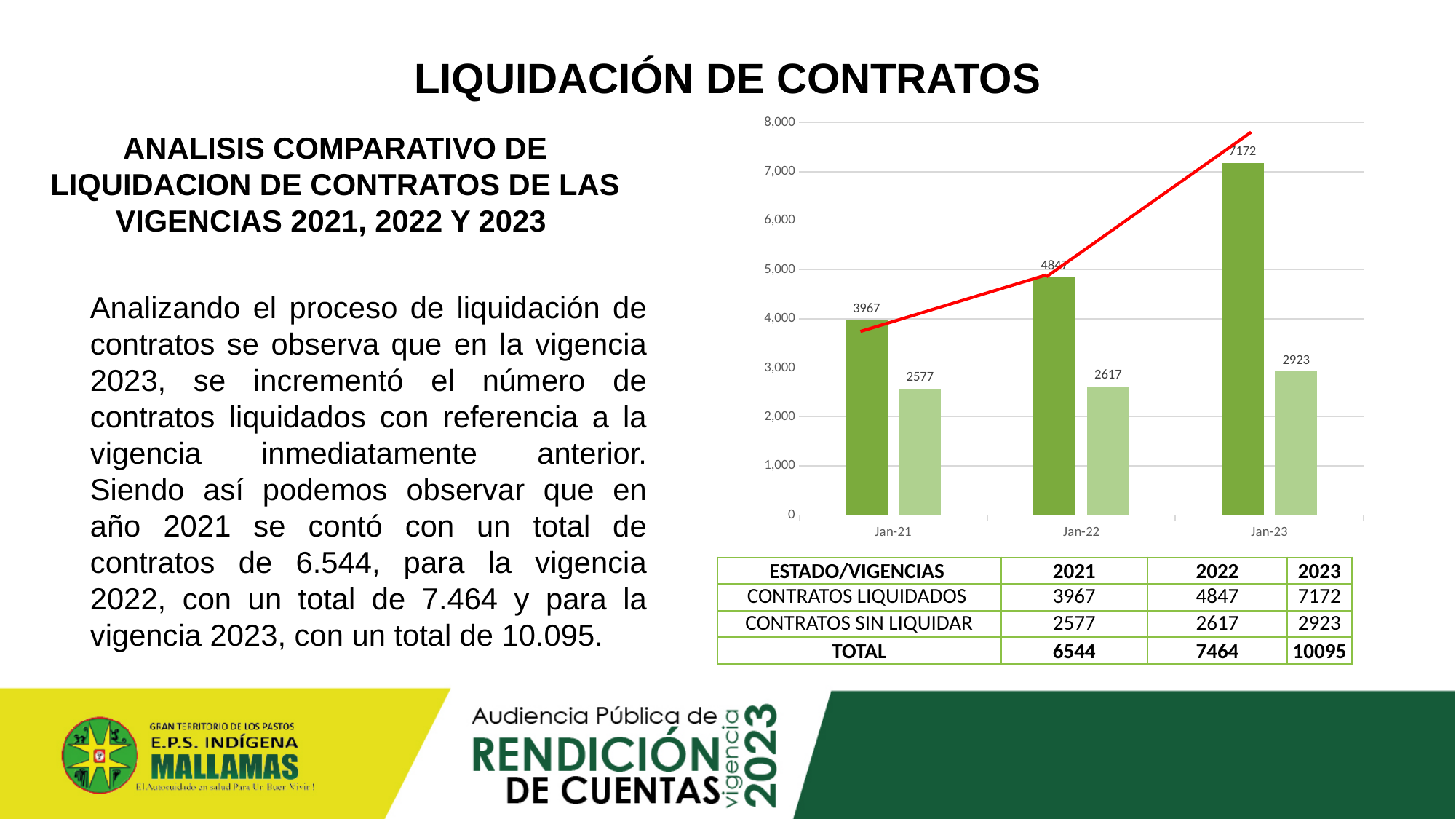
Do the dark green bars rise or fall from Jan-21 to Jan-23? Rise What kind of chart is shown on the slide? Bar chart How many categories are shown on the x axis of the chart? 3 Which is larger: the dark green bar for Jan-21 or the light green bar for Jan-22? The dark green bar for Jan-21 What is the value of the dark green bar for Jan-22? 4847 Which category has the lowest light green bar? Jan-21 Which category has the highest dark green bar? Jan-23 What is the value of the light green bar for Jan-23? 2923 What is the value of the light green bar for Jan-21? 2577 Is the value of the dark green bar for Jan-23 greater or less than 7,000? greater What is the difference between the dark green bar for Jan-23 and the dark green bar for Jan-22? 2325 What is the value of the dark green bar for Jan-23? 7172